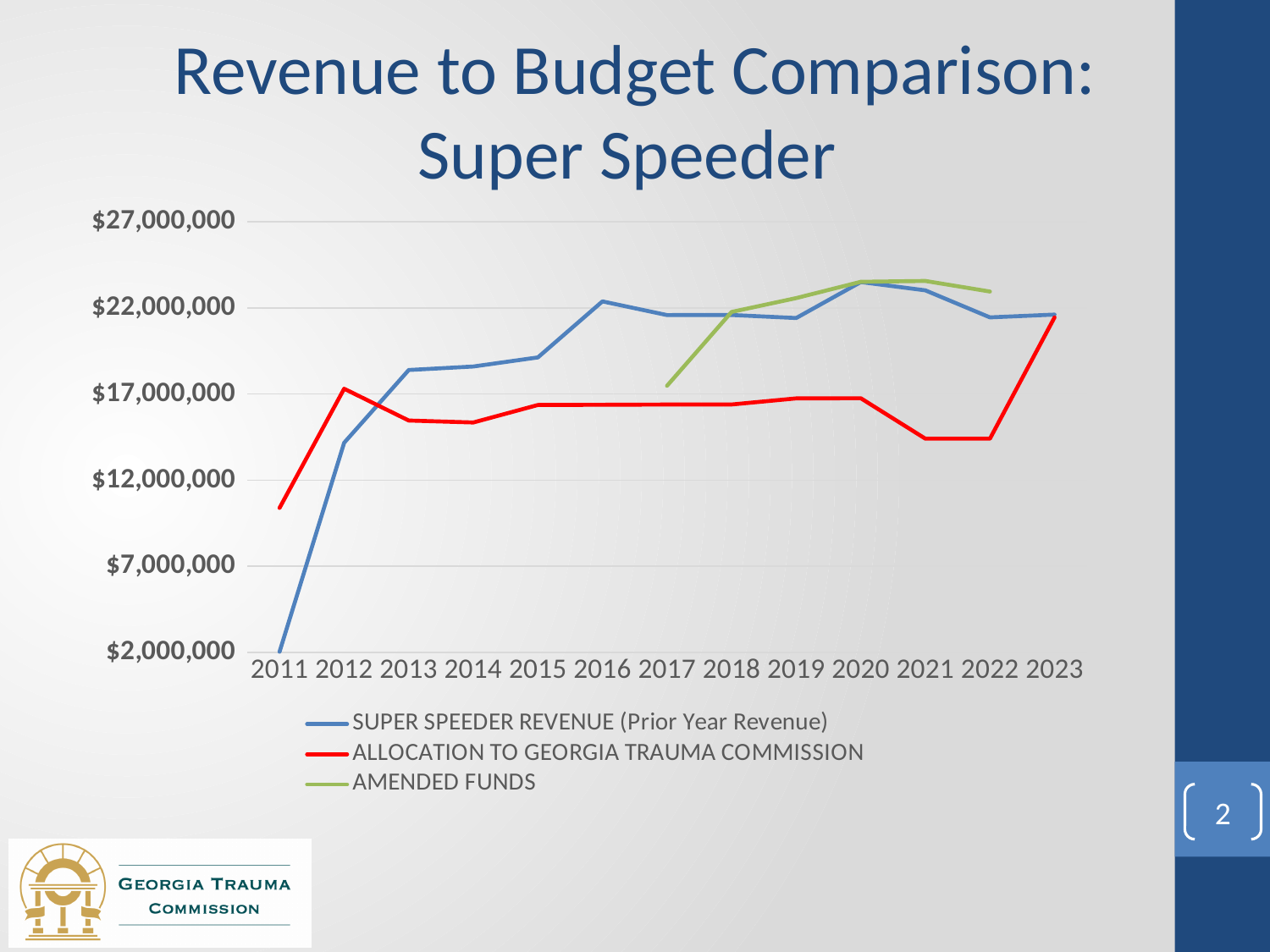
In 2013, which is larger: SUPER SPEEDER REVENUE (Prior Year Revenue) or ALLOCATION TO GEORGIA TRAUMA COMMISSION? SUPER SPEEDER REVENUE (Prior Year Revenue) How many series does the legend list? 3 In which year is SUPER SPEEDER REVENUE (Prior Year Revenue) at its lowest? 2011 Does ALLOCATION TO GEORGIA TRAUMA COMMISSION rise or fall from 2020 to 2021? Fall Is the value for ALLOCATION TO GEORGIA TRAUMA COMMISSION in 2021 greater or less than $17,000,000? less Is the value for ALLOCATION TO GEORGIA TRAUMA COMMISSION in 2011 greater or less than $12,000,000? less In which year is ALLOCATION TO GEORGIA TRAUMA COMMISSION at its highest? 2023 What kind of chart is shown on the slide? Line chart Is the value for SUPER SPEEDER REVENUE (Prior Year Revenue) in 2012 greater or less than $12,000,000? greater Which series is drawn with a green line? AMENDED FUNDS How many years are shown along the x axis? 13